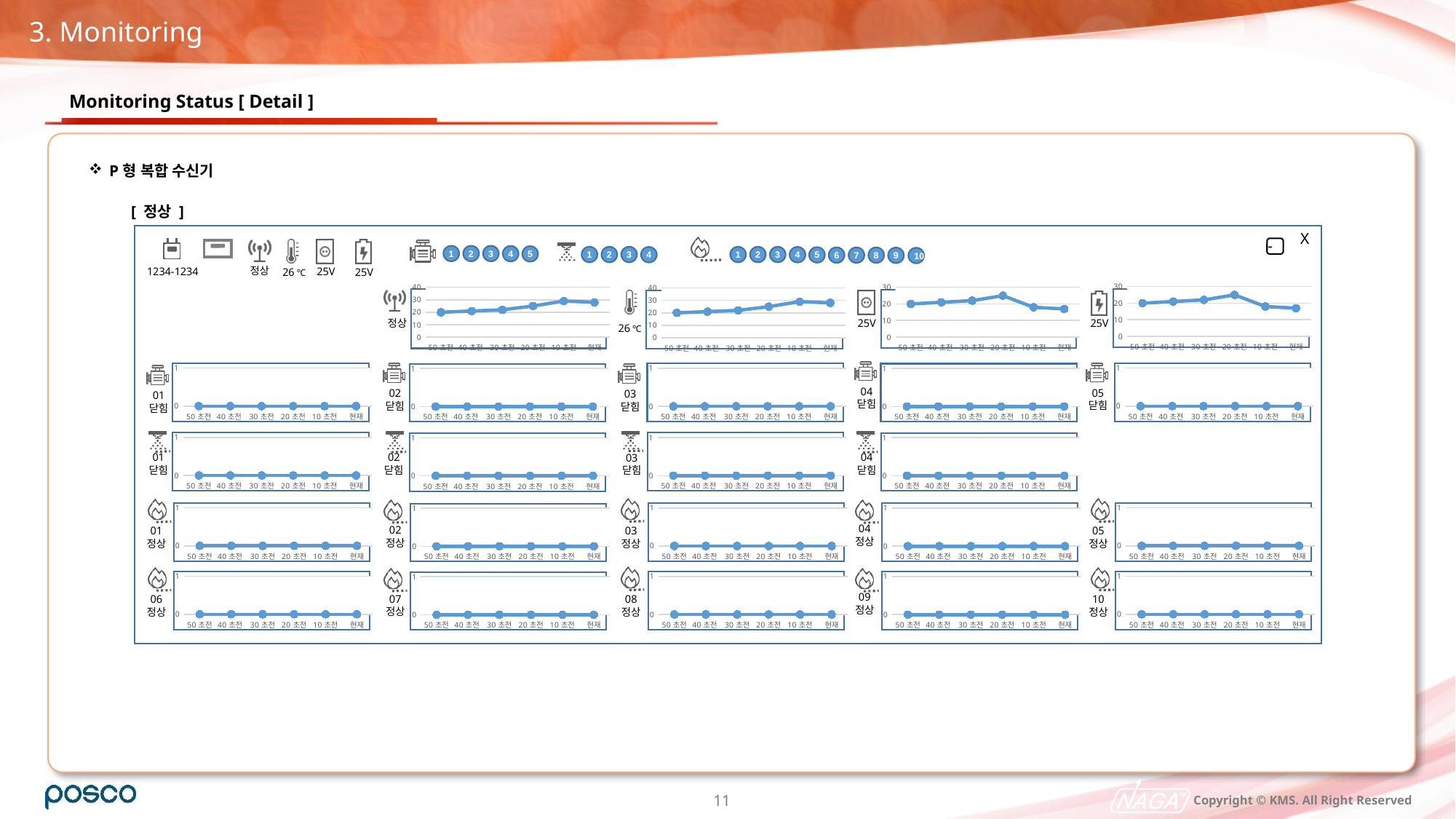
In the top-row chart next to the thermometer icon (26 ℃), do the values rise or fall from 50 초전 to 현재? rise What is the label of the last x-axis tick on the top-left chart next to the signal icon? 현재 In the top-row chart next to the thermometer icon (26 ℃), is the value at 50 초전 greater or less than 30? less What kind of chart is the top-left chart next to the signal icon labelled 정상? line chart In the top-left chart next to the signal icon, is the value at 현재 greater or less than 10? greater In the top-left chart next to the signal icon, do the values rise or fall from 50 초전 to 현재? rise What is the first x-axis label on the top-left chart next to the signal icon? 50 초전 What is the highest y-axis tick shown on the top-left chart next to the signal icon? 40 In the chart labelled 01 닫힘 (motor icon), is the value at 현재 greater or less than 1? less In the top-row chart next to the power plug icon (25V), at which x-axis point is the value highest? 20 초전 How many data points are plotted in the top-left line chart next to the signal icon? 6